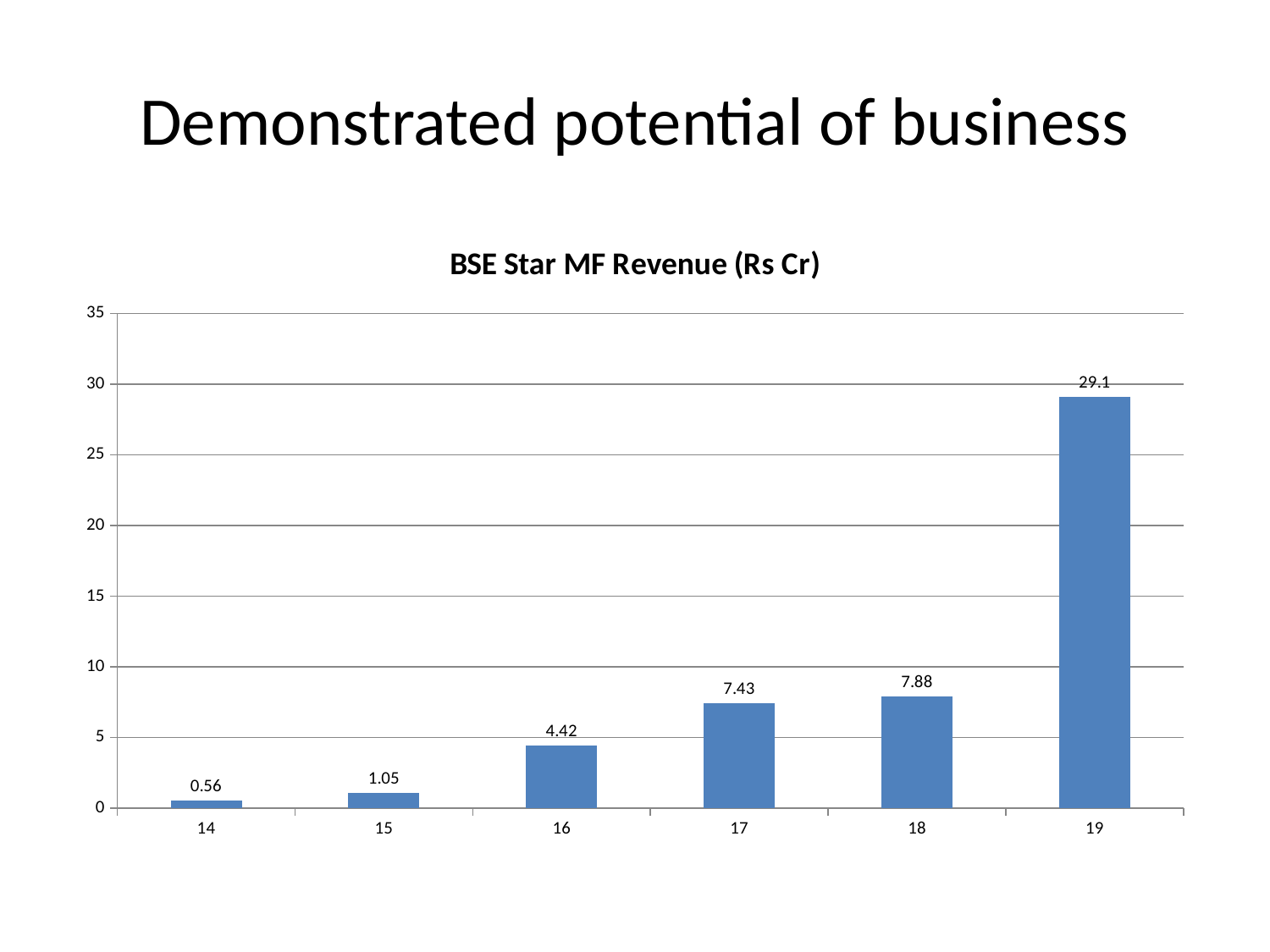
Is the BSE Star MF Revenue for 18 greater or less than 10? less What is the difference in BSE Star MF Revenue (Rs Cr) between 19 and 18? 21.22 Which has a higher BSE Star MF Revenue, 16 or 17? 17 How many years are shown on the BSE Star MF Revenue chart? 6 What is the BSE Star MF Revenue (Rs Cr) for 17? 7.43 What is the BSE Star MF Revenue (Rs Cr) for 14? 0.56 What kind of chart is used to show BSE Star MF Revenue? bar chart Which year has the highest BSE Star MF Revenue? 19 Which year has the lowest BSE Star MF Revenue? 14 What is the BSE Star MF Revenue (Rs Cr) for 19? 29.1 What is the difference in BSE Star MF Revenue (Rs Cr) between 16 and 15? 3.37 Does the BSE Star MF Revenue rise or fall from 14 to 19? rise